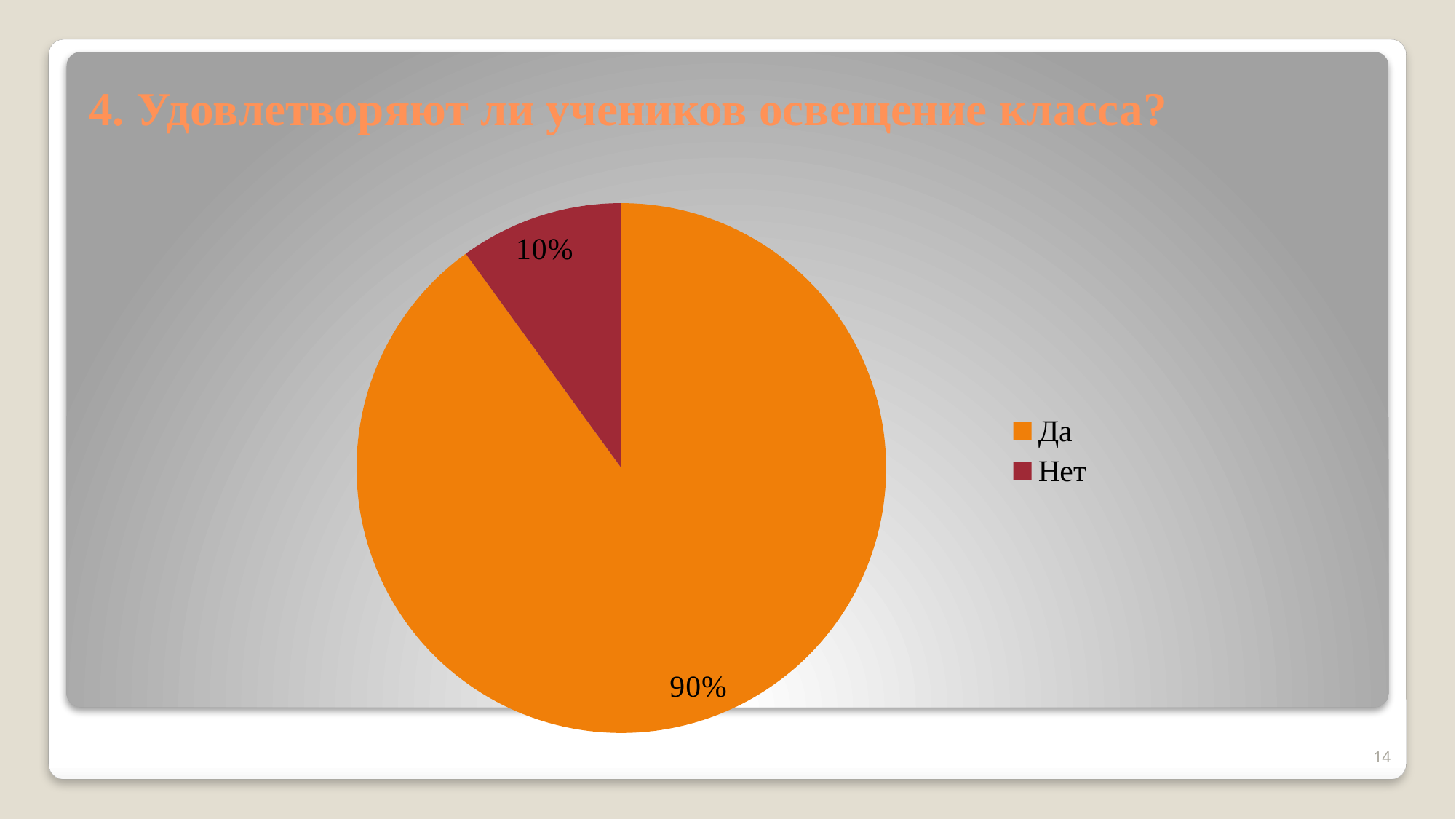
How many slices does the pie chart have? 2 What is the difference in percentage points between the "Да" and "Нет" slices? 80 How many entries does the legend list? 2 Which slice of the pie is the largest? Да Which slice of the pie is the smallest? Нет What colour is the "Нет" slice in the pie chart? dark red What kind of chart is shown on the slide? pie chart What is the title of the slide containing the chart? 4. Удовлетворяют ли учеников освещение класса? What share of the pie does "Нет" represent? 10% Which is larger, the "Да" slice or the "Нет" slice? Да What share of the pie does "Да" represent? 90%